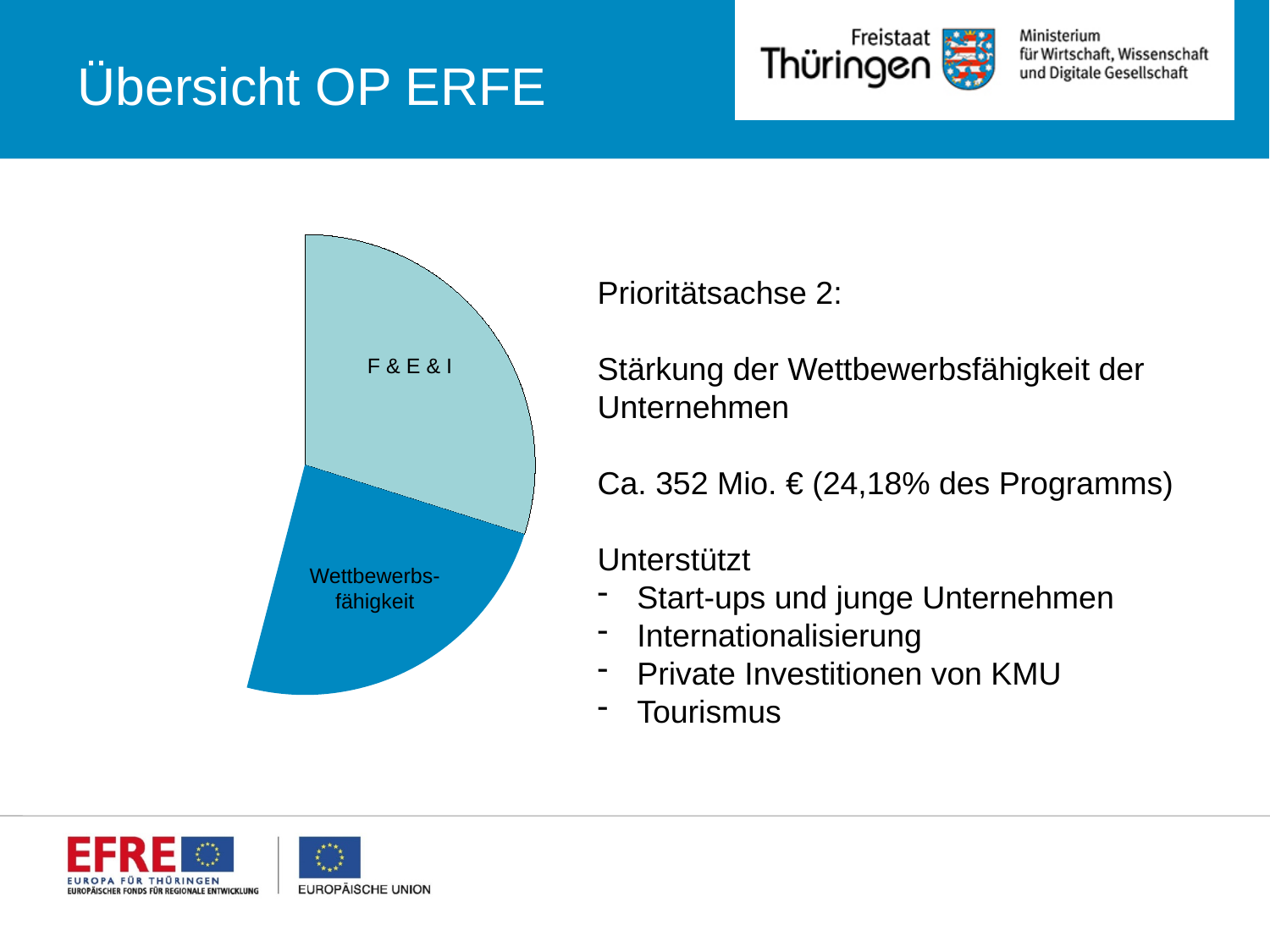
Which labelled slice of the pie chart is the largest? F & E & I Which labelled slice of the pie chart is larger, F & E & I or Wettbewerbsfähigkeit? F & E & I Which labelled slice of the pie chart is the smallest? Wettbewerbsfähigkeit Which slice of the pie chart is drawn in the light blue colour? F & E & I How many labelled slices does the pie chart show? 2 What kind of chart is shown on the slide? pie chart Which slice of the pie chart is drawn in the darker blue colour? Wettbewerbsfähigkeit